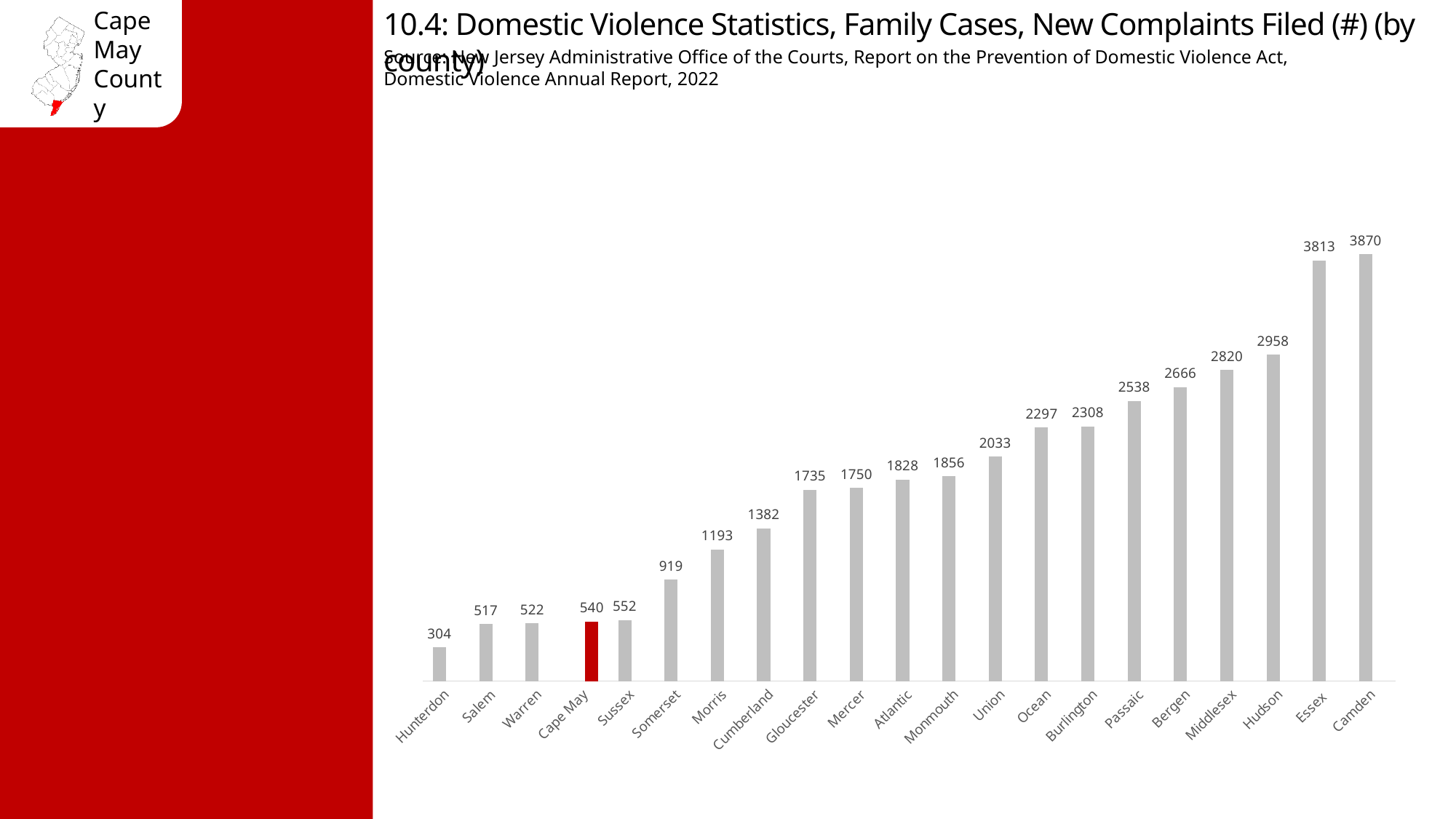
What is the difference between the values for Cape May and Hunterdon? 236 What is the difference between the values for Camden and Essex? 57 What is the value shown for Hudson? 2958 How many counties are shown on the chart? 21 What kind of chart is shown on the slide? Bar chart Which county's bar is highlighted in red? Cape May Which county has the highest number of new complaints filed? Camden What is the number of new domestic violence complaints filed for Cape May? 540 What is the value shown for Gloucester? 1735 Which county has the lowest number of new complaints filed? Hunterdon Which has a larger value, Union or Ocean? Ocean Which has a larger value, Morris or Somerset? Morris